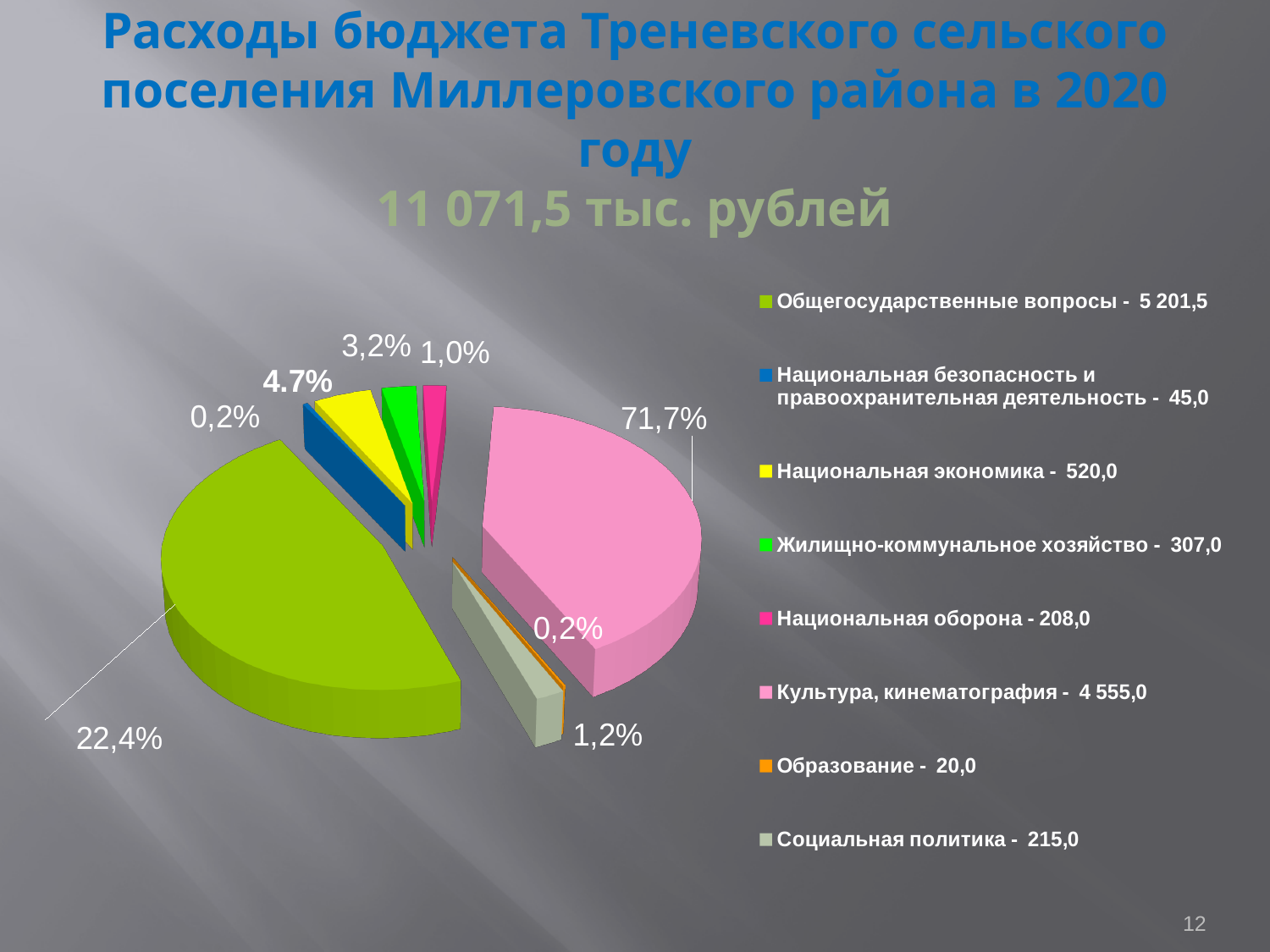
What percentage label is shown for the yellow slice (Национальная экономика)? 4.7% What value is given in the legend for Национальная экономика? 520,0 Which category has the smallest value in the legend? Образование How many categories does the legend of the pie chart list? 8 What value is given in the legend for Образование? 20,0 What is the difference between the legend values for Общегосударственные вопросы and Культура, кинематография? 646,5 What value is given in the legend for Культура, кинематография? 4 555,0 What value is given in the legend for Общегосударственные вопросы? 5 201,5 Which category has the largest value in the legend? Общегосударственные вопросы What kind of chart is shown on the slide? pie chart Which has the larger legend value: Жилищно-коммунальное хозяйство or Национальная оборона? Жилищно-коммунальное хозяйство What total budget expenditure amount is stated in the slide title? 11 071,5 тыс. рублей